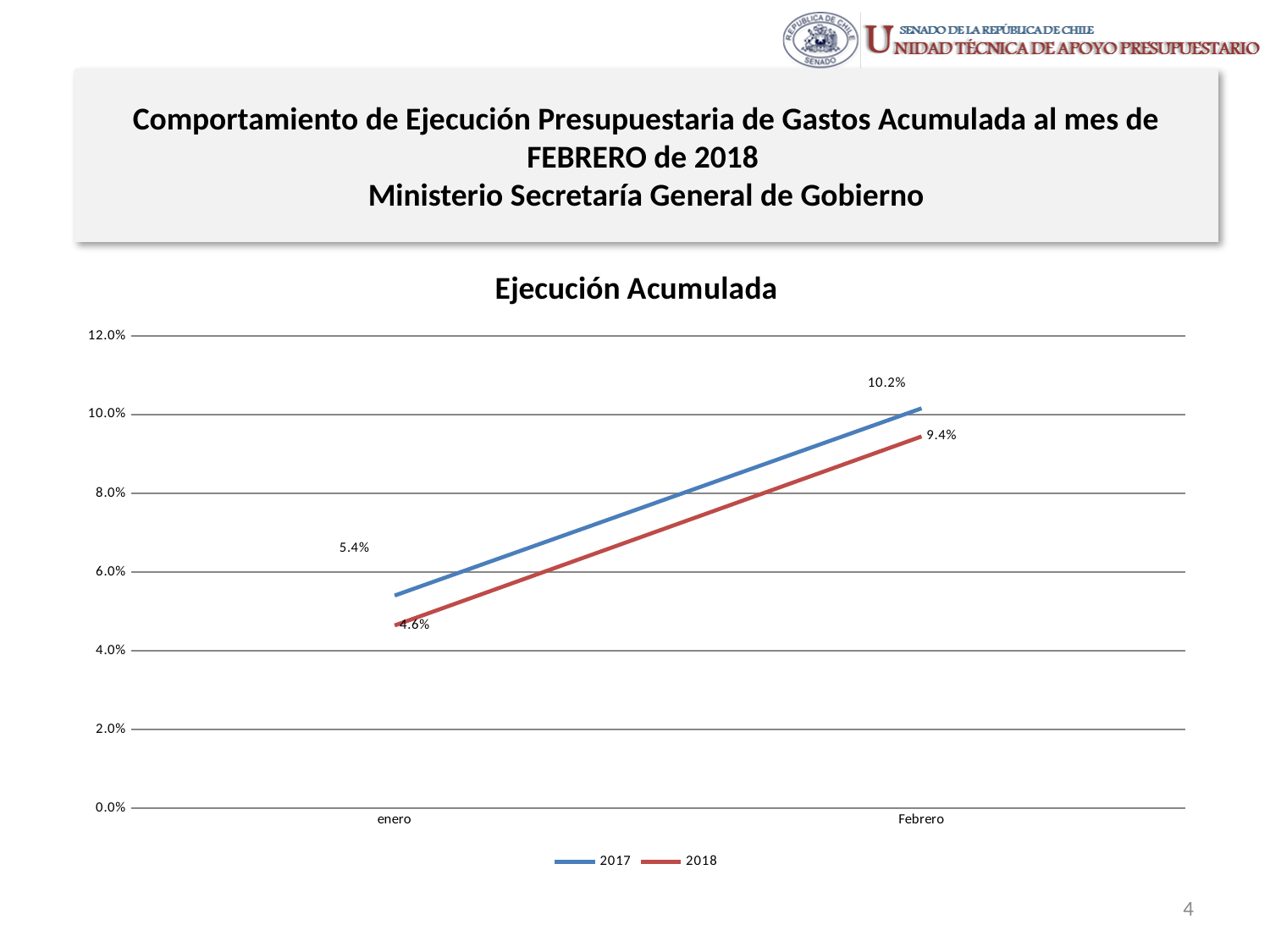
How many series does the legend list? 2 What is the value for 2017 in enero? 5.4% Do the values for 2018 rise or fall from enero to Febrero? rise What is the value for 2017 in Febrero? 10.2% What is the value for 2018 in Febrero? 9.4% What is the difference between the 2017 and 2018 values in enero? 0.8% Which series has the higher value in Febrero, 2017 or 2018? 2017 What kind of chart is shown? line chart How many categories are shown on the x axis? 2 What is the difference between the 2017 and 2018 values in Febrero? 0.8% What is the value for 2018 in enero? 4.6% Is the value for 2018 in Febrero greater or less than 10.0%? less